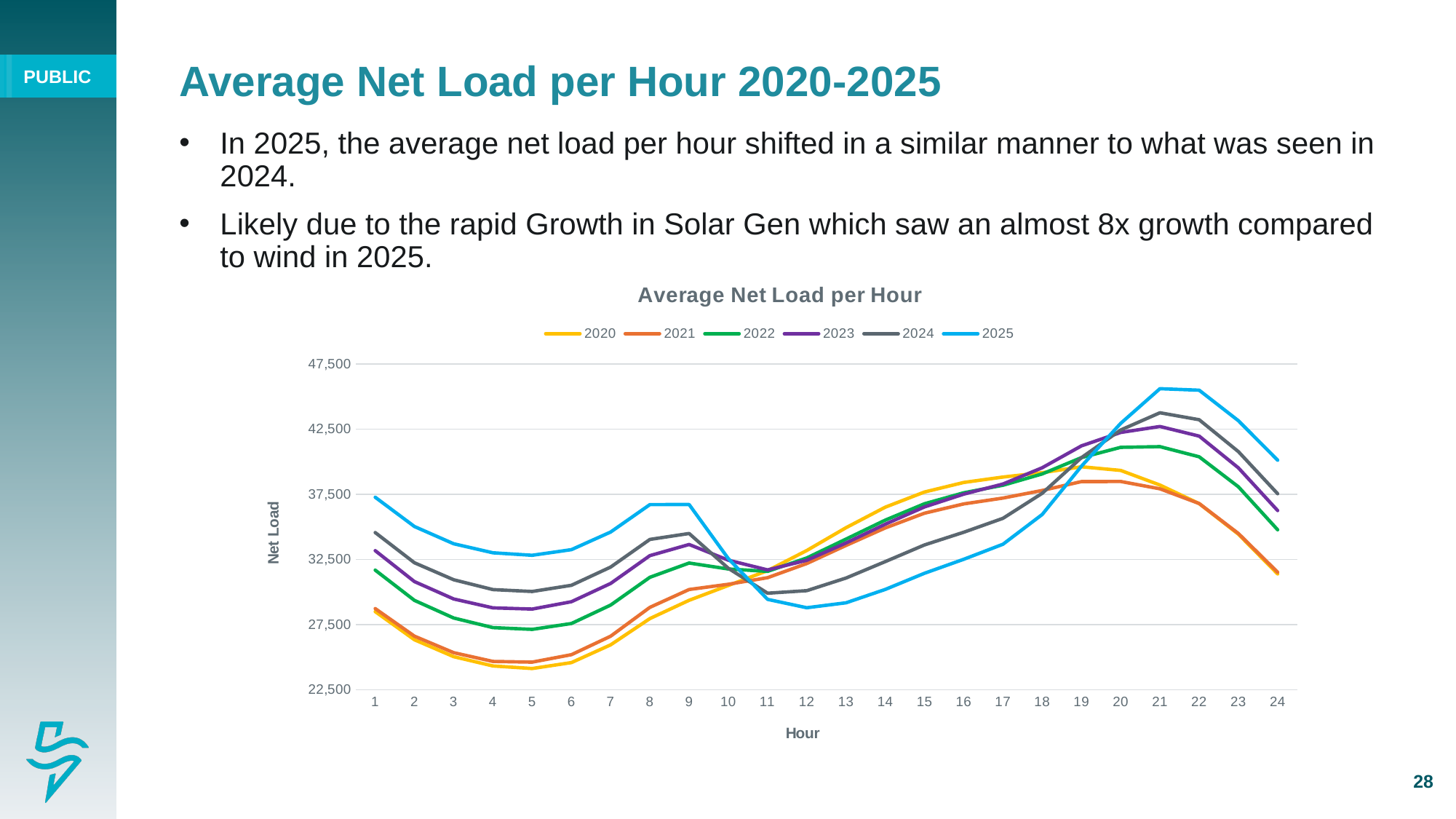
How many series does the legend list? 6 What is the title of the chart? Average Net Load per Hour Does the 2025 line rise or fall between hour 12 and hour 21? rise Which year has the lowest net load at hour 12? 2025 At hour 18, which is larger: the value for 2020 or the value for 2025? 2020 At hour 8, which is larger: the value for 2025 or the value for 2020? 2025 Which year has the highest net load at hour 21? 2025 Is the value for 2025 at hour 21 greater or less than 42,500? greater How many hours are plotted along the x axis? 24 Is the value for 2020 at hour 5 greater or less than 27,500? less Is the value for 2024 at hour 1 greater or less than 32,500? greater What kind of chart is shown on the slide? line chart